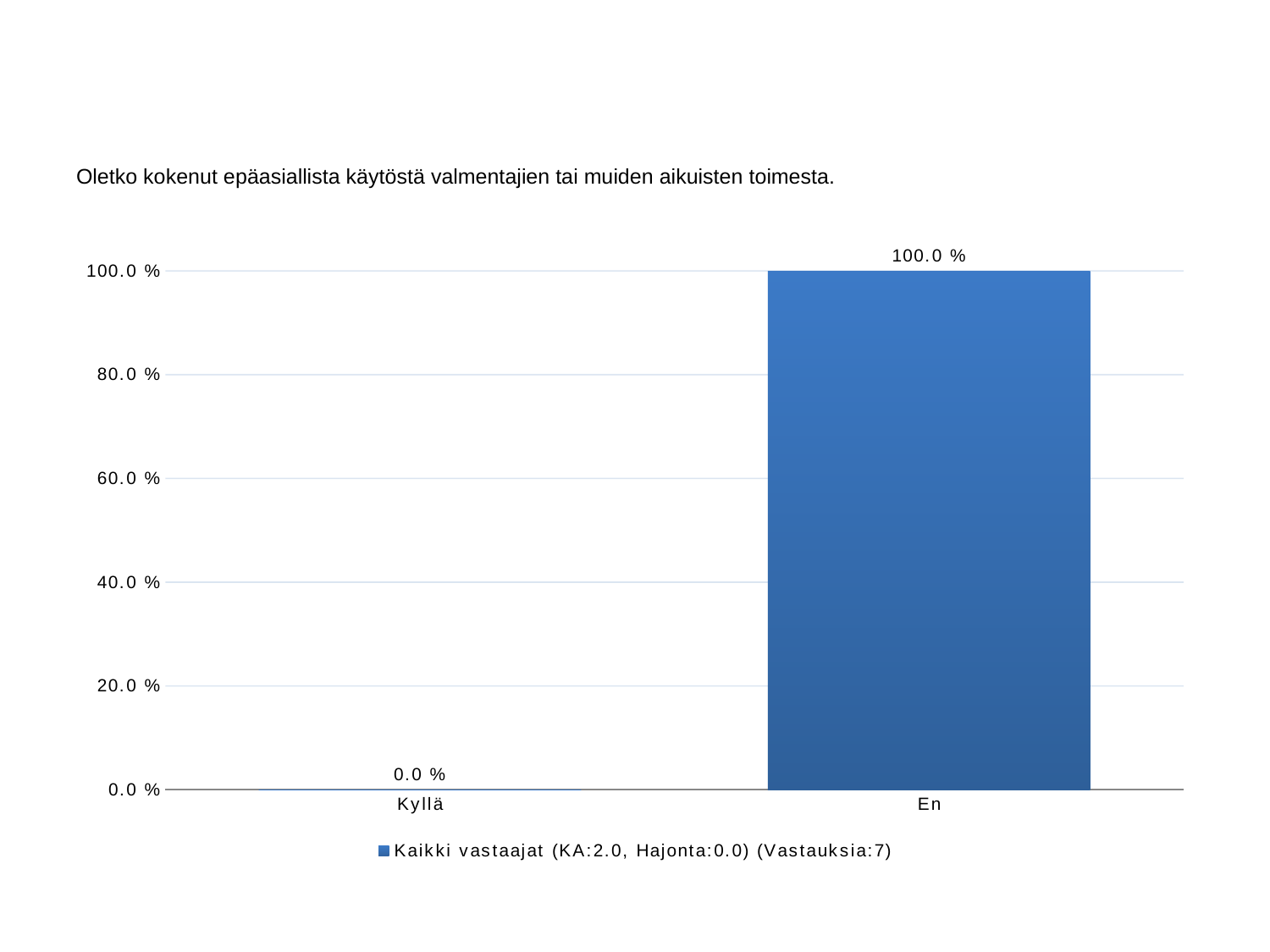
What is the difference between the values for "En" and "Kyllä"? 100.0 % What is the value for "Kyllä"? 0.0 % Is the value for "En" greater or less than 80.0 %? greater Which category has the lowest value? Kyllä What is the legend entry for the series? Kaikki vastaajat (KA:2.0, Hajonta:0.0) (Vastauksia:7) How many categories are shown on the x axis? 2 Which is larger, the value for "Kyllä" or the value for "En"? En Which category has the highest value? En How many series does the legend list? 1 What kind of chart is shown on the slide? bar chart What is the title of the chart? Oletko kokenut epäasiallista käytöstä valmentajien tai muiden aikuisten toimesta. What is the value for "En"? 100.0 %